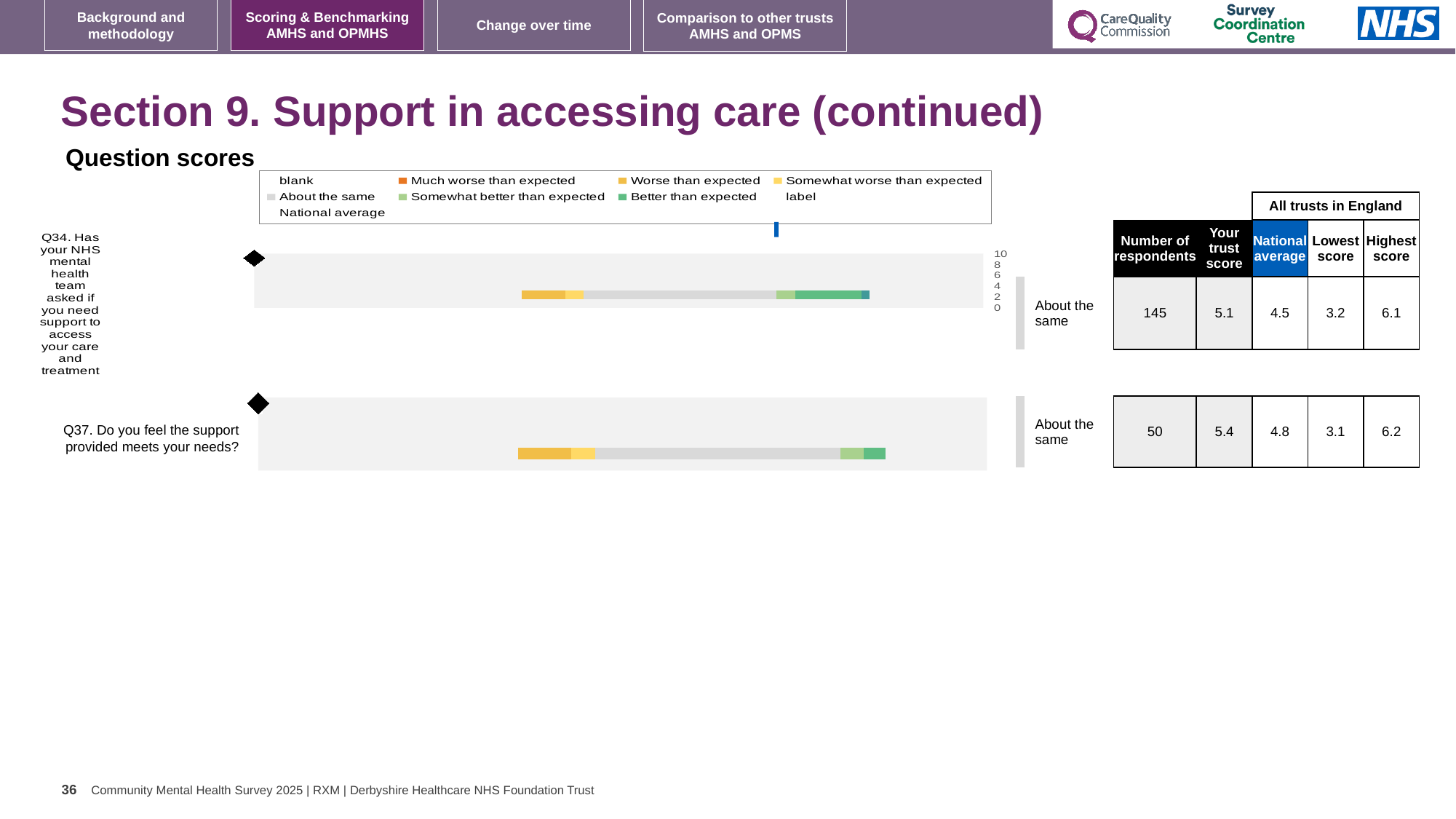
What kind of chart is used to show the question scores for Q34 and Q37? bar chart What benchmark category is shown to the right of the bar for Q34? About the same In the table beside the chart, what is your trust score for Q34? 5.1 How many questions are plotted in the question scores chart? 2 In the table beside the chart, which question has the higher trust score, Q34 or Q37? Q37 What benchmark category is shown to the right of the bar for Q37? About the same In the table beside the chart, what is the difference between your trust score and the national average for Q34? 0.6 In the table beside the chart, what is the number of respondents for Q34? 145 In the table beside the chart, what is the lowest score among all trusts in England for Q37? 3.1 In the table beside the chart, what is the number of respondents for Q37? 50 In the table beside the chart, what is the national average for Q37? 4.8 In the table beside the chart, what is the highest score among all trusts in England for Q34? 6.1